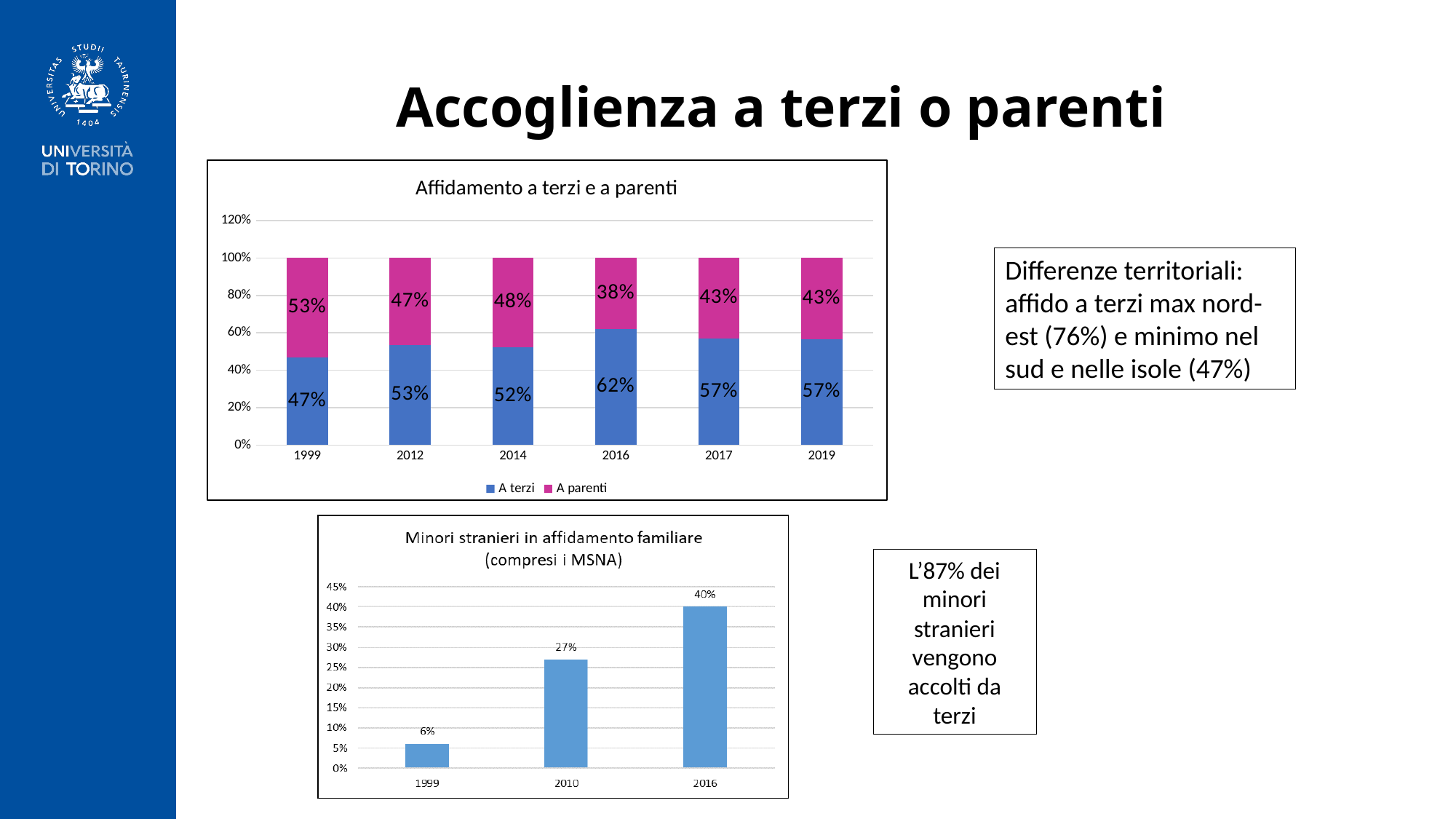
In the chart 'Affidamento a terzi e a parenti', how many series does the legend list? 2 In the chart 'Affidamento a terzi e a parenti', which year has the highest value for 'A terzi'? 2016 In the chart 'Minori stranieri in affidamento familiare (compresi i MSNA)', do the values rise or fall from 1999 to 2016? Rise In the chart 'Affidamento a terzi e a parenti', which colour represents 'A parenti'? Magenta (pink) In the chart 'Affidamento a terzi e a parenti', what is the difference between 'A terzi' and 'A parenti' in 2017? 14% In the chart 'Affidamento a terzi e a parenti', what is the value for 'A parenti' in 1999? 53% In the chart 'Minori stranieri in affidamento familiare (compresi i MSNA)', what is the difference between the values for 2016 and 1999? 34% In the chart 'Affidamento a terzi e a parenti', which year has the lowest value for 'A parenti'? 2016 What kind of chart is 'Minori stranieri in affidamento familiare (compresi i MSNA)'? Bar chart In the chart 'Affidamento a terzi e a parenti', how many years are shown on the x axis? 6 In the chart 'Minori stranieri in affidamento familiare (compresi i MSNA)', what is the value for 2010? 27% In the chart 'Affidamento a terzi e a parenti', what is the value for 'A terzi' in 2016? 62%